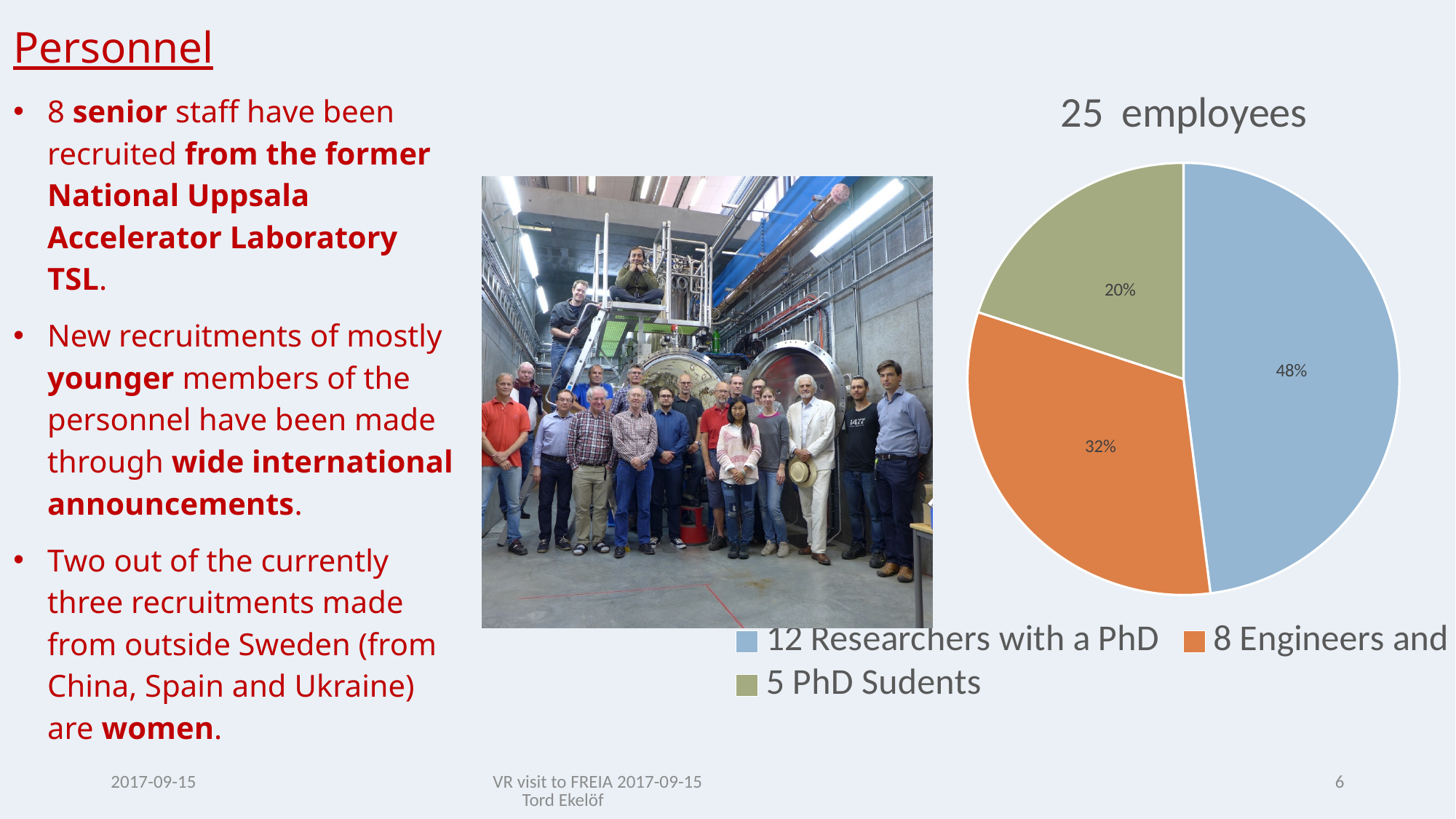
What share of the pie does the "5 PhD Sudents" slice represent? 20% What kind of chart is shown on the slide? pie chart How many entries does the legend of the pie chart list? 3 What is the difference in percentage points between the 48% slice and the 20% slice? 28 Which is larger: the share for "12 Researchers with a PhD" or the share for the orange slice? 12 Researchers with a PhD What is the title of the pie chart? 25 employees Which colour represents "5 PhD Sudents" in the pie chart? green Which slice of the pie chart is the largest? 12 Researchers with a PhD What percentage is shown on the orange slice of the pie chart? 32% Which slice of the pie chart is the smallest? 5 PhD Sudents What share of the pie does the "12 Researchers with a PhD" slice represent? 48% How many slices does the pie chart have? 3